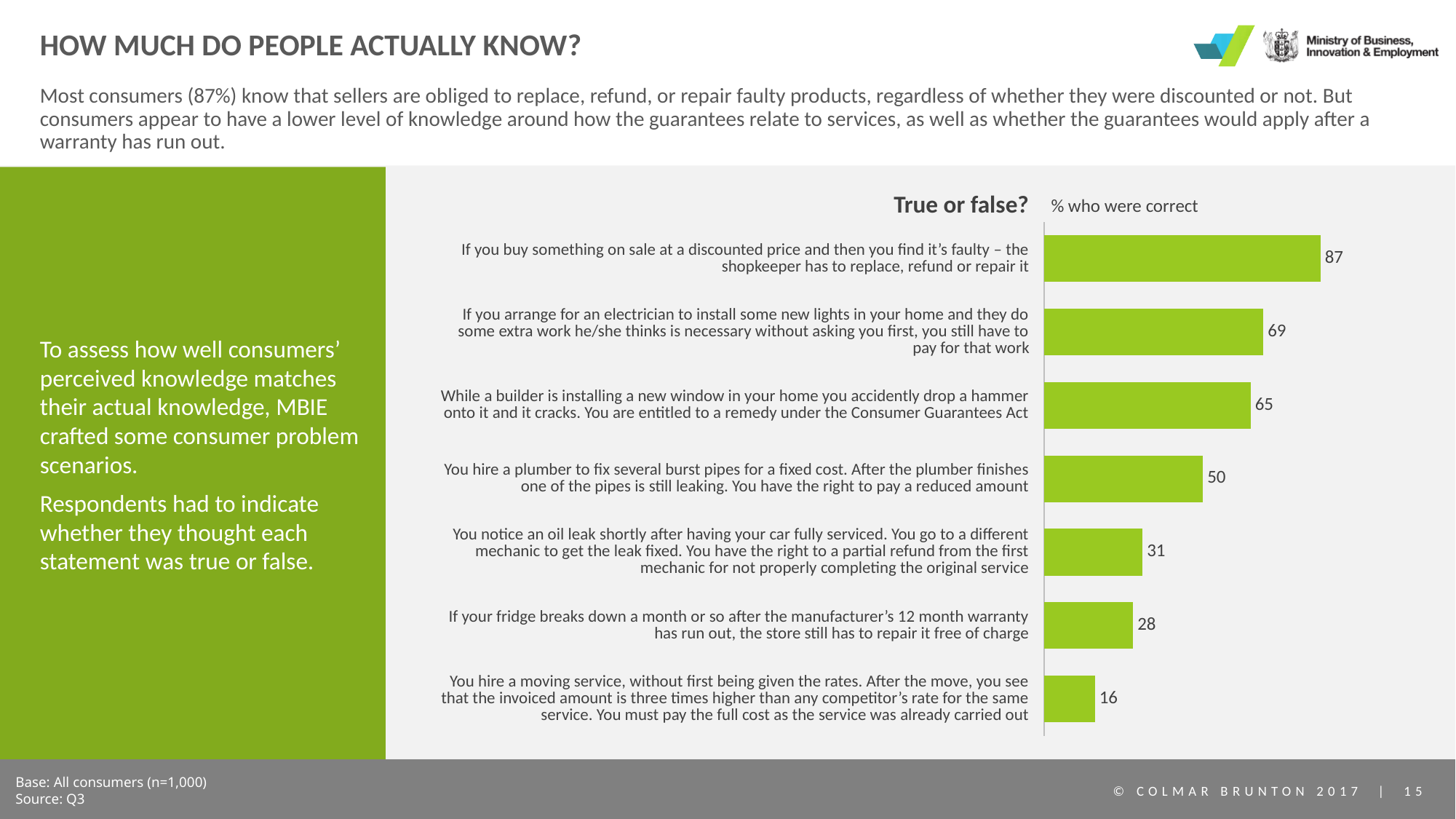
What does the chart measure, according to the label next to the 'True or false?' heading? % who were correct Which had a higher percentage correct: the oil leak/mechanic statement or the fridge warranty statement? The oil leak/mechanic statement What is the difference in percentage correct between the discounted-price statement and the moving service statement? 71 What type of chart is used on this slide? Bar chart What percentage of respondents were correct on the statement about buying something on sale at a discounted price and finding it faulty? 87 What percentage were correct on the statement about the moving service invoicing three times higher than competitors? 16 Which statement had the highest percentage of correct answers? If you buy something on sale at a discounted price and then you find it's faulty – the shopkeeper has to replace, refund or repair it What percentage were correct on the statement about the electrician doing extra work without asking first? 69 What is the difference in percentage correct between the builder/window statement and the plumber/burst pipes statement? 15 Which statement had the lowest percentage of correct answers? You hire a moving service, without first being given the rates... You must pay the full cost as the service was already carried out How many true-or-false statements are shown in the chart? 7 What percentage were correct on the statement about the fridge breaking down after the 12 month warranty has run out? 28